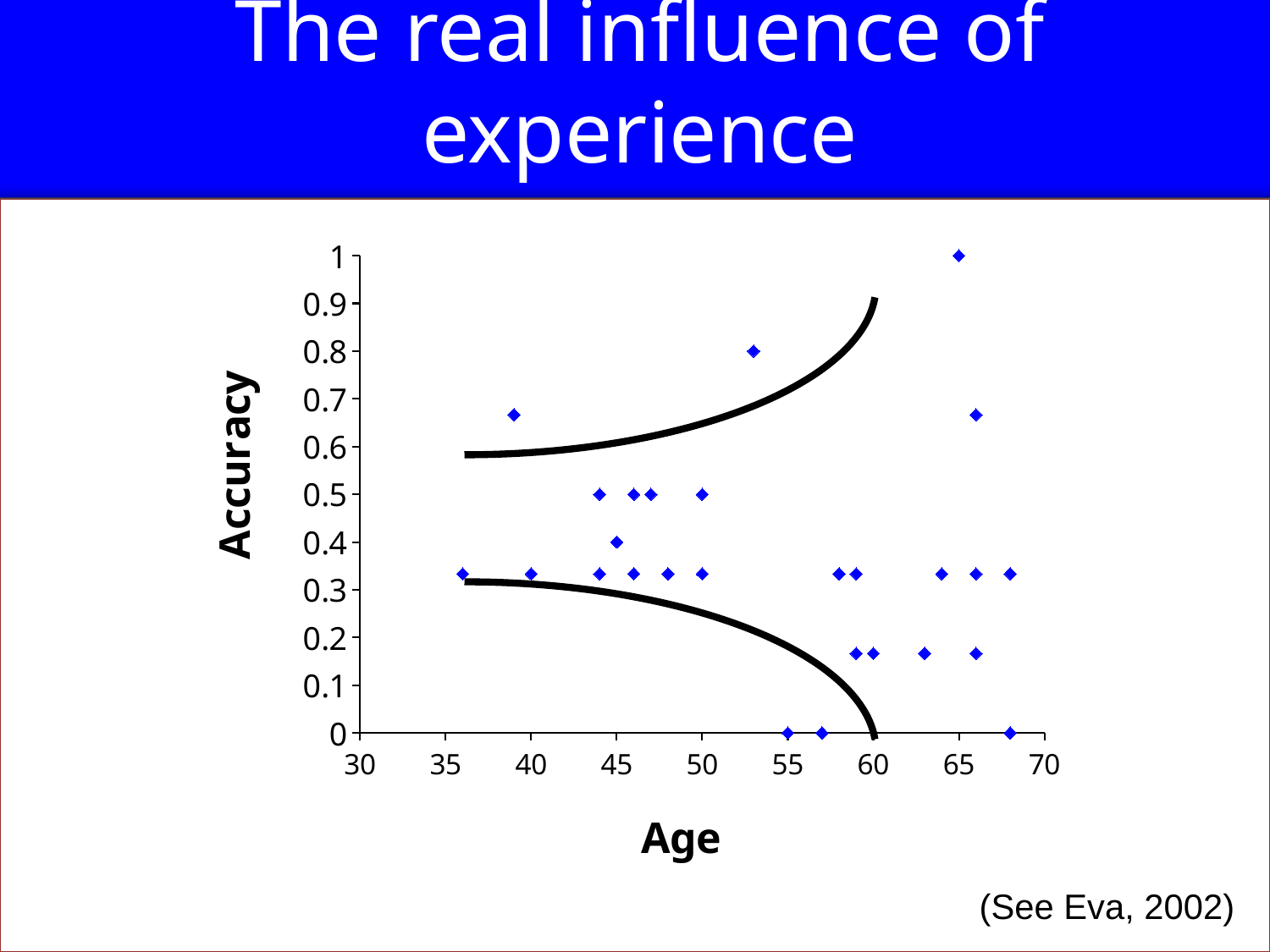
What is the label of the x axis? Age What is the accuracy of the point plotted at age 53? 0.8 What is the lowest accuracy value plotted on the chart? 0 Is the accuracy of the point at age 39 greater or less than 0.6? greater What kind of chart is shown on the slide? scatter plot What is the label of the y axis? Accuracy Which has the higher accuracy: the point at age 53 or the point at age 39? age 53 At what age does the point with the highest accuracy occur? 65 What is the accuracy of the point plotted at age 45? 0.4 What is the maximum value shown on the Age axis? 70 What is the highest accuracy value plotted on the chart? 1 Is the accuracy of the point at age 63 greater or less than 0.2? less